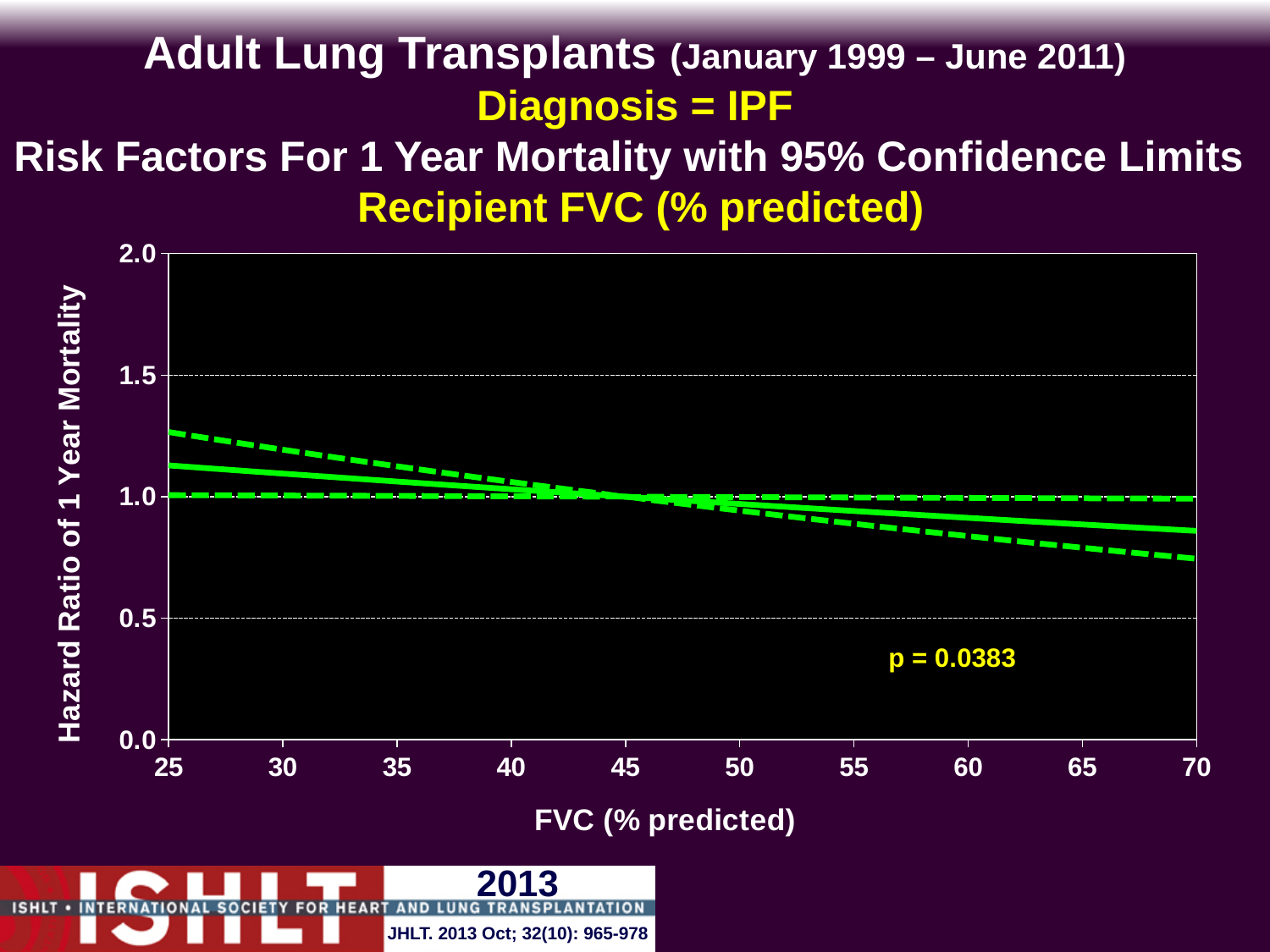
How many lines are plotted on the chart? 3 What is the label of the x axis? FVC (% predicted) What is the label of the y axis? Hazard Ratio of 1 Year Mortality Which is larger, the hazard ratio of 1 year mortality at an FVC of 30% predicted or at an FVC of 65% predicted? 30% predicted What kind of chart is shown on the slide? line chart Does the hazard ratio of 1 year mortality rise or fall as FVC (% predicted) increases from 25 to 70? fall Is the hazard ratio of 1 year mortality at an FVC of 70% predicted greater or less than 1.0? less What is the highest value shown on the y axis? 2.0 What p-value is printed on the chart? p = 0.0383 Is the upper 95% confidence limit at an FVC of 25% predicted greater or less than 1.5? less Is the lower 95% confidence limit at an FVC of 70% predicted greater or less than 0.5? greater